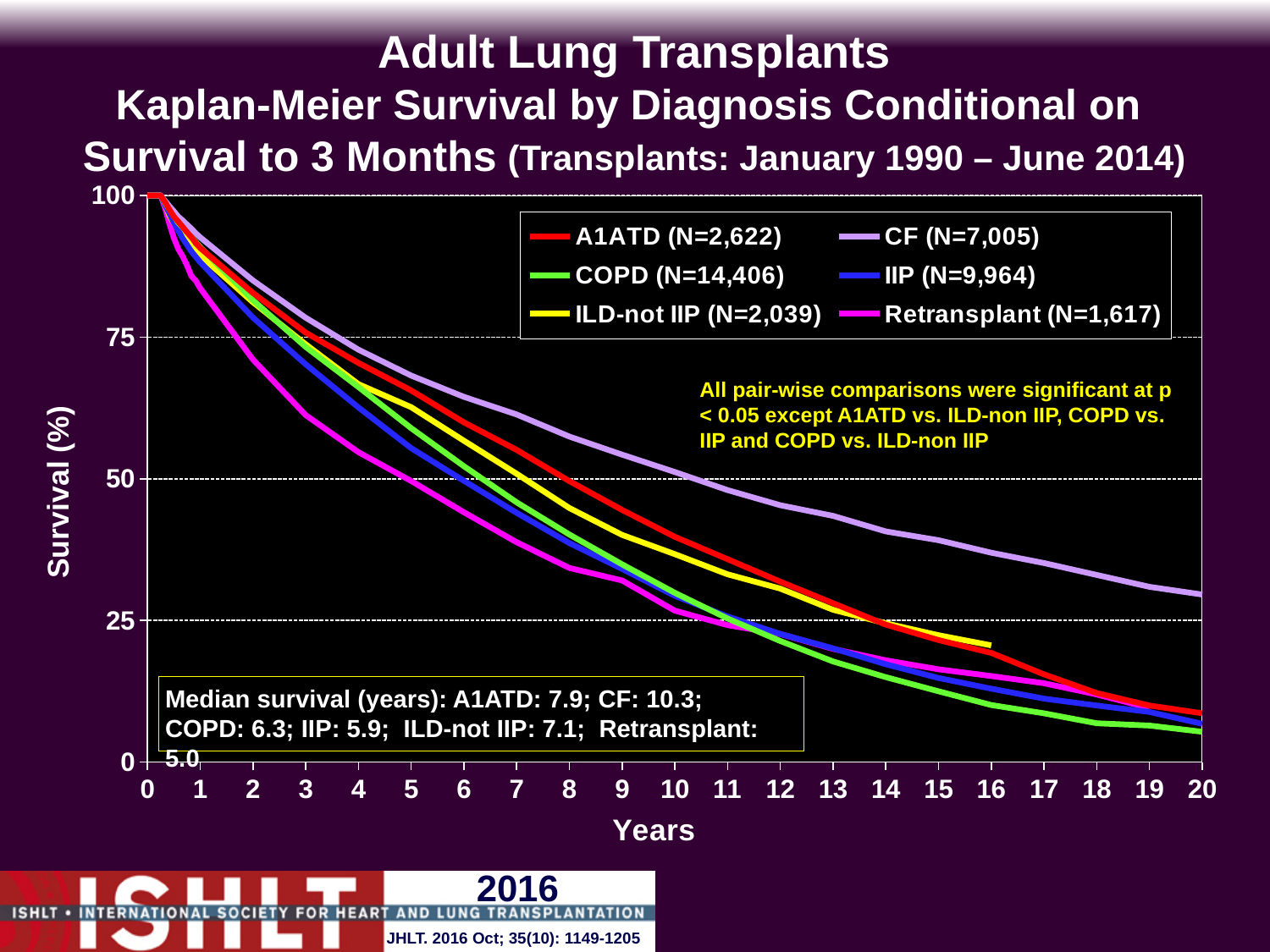
Do the survival curves rise or fall as years increase? fall How many series does the legend list? 6 Is the survival value for A1ATD at 15 years greater or less than 25? less What is the difference in median survival (years) between CF and COPD? 4.0 What is the median survival in years for CF? 10.3 Which diagnosis group has the lowest median survival? Retransplant What kind of chart is shown on the slide? line chart Which diagnosis group has the highest median survival? CF What is the median survival in years for Retransplant? 5.0 What is the N shown in the legend for COPD? 14,406 Is the survival value for CF at 20 years greater or less than 25? greater Which has the larger median survival, A1ATD or ILD-not IIP? A1ATD